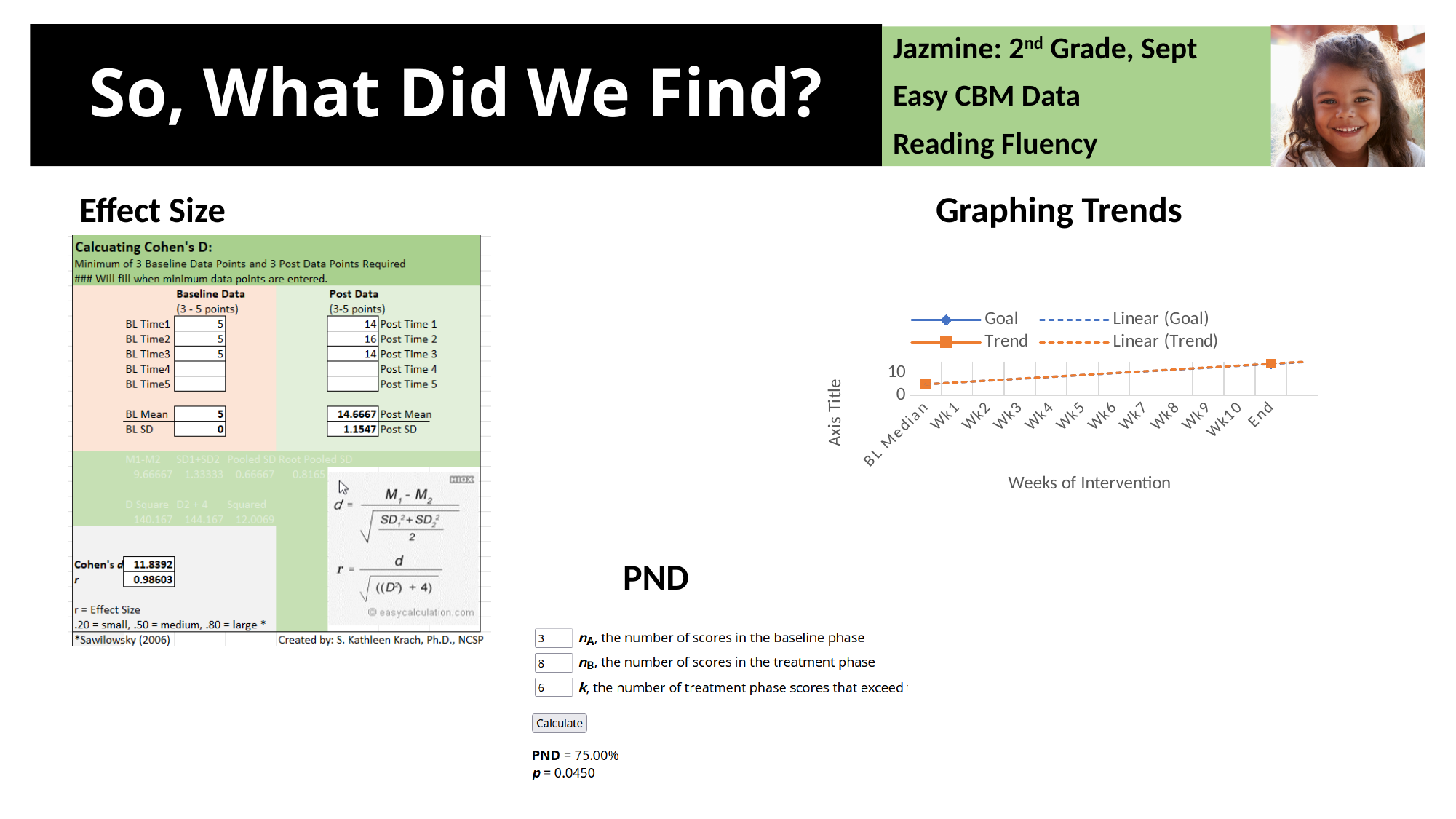
In the "Graphing Trends" chart, is the Trend value at BL Median greater or less than 10? less How many categories are on the x axis of the "Graphing Trends" chart? 12 What is the first category on the x axis of the "Graphing Trends" chart? BL Median How many entries does the legend of the "Graphing Trends" chart list? 4 In the "Graphing Trends" chart, which is larger for the Trend series: the value at BL Median or the value at End? End In the "Graphing Trends" chart, is the Trend value at End greater or less than 10? greater In the "Graphing Trends" chart, does the Trend series rise or fall from BL Median to End? rise What is the x-axis title of the "Graphing Trends" chart? Weeks of Intervention What kind of chart is shown under "Graphing Trends"? line chart